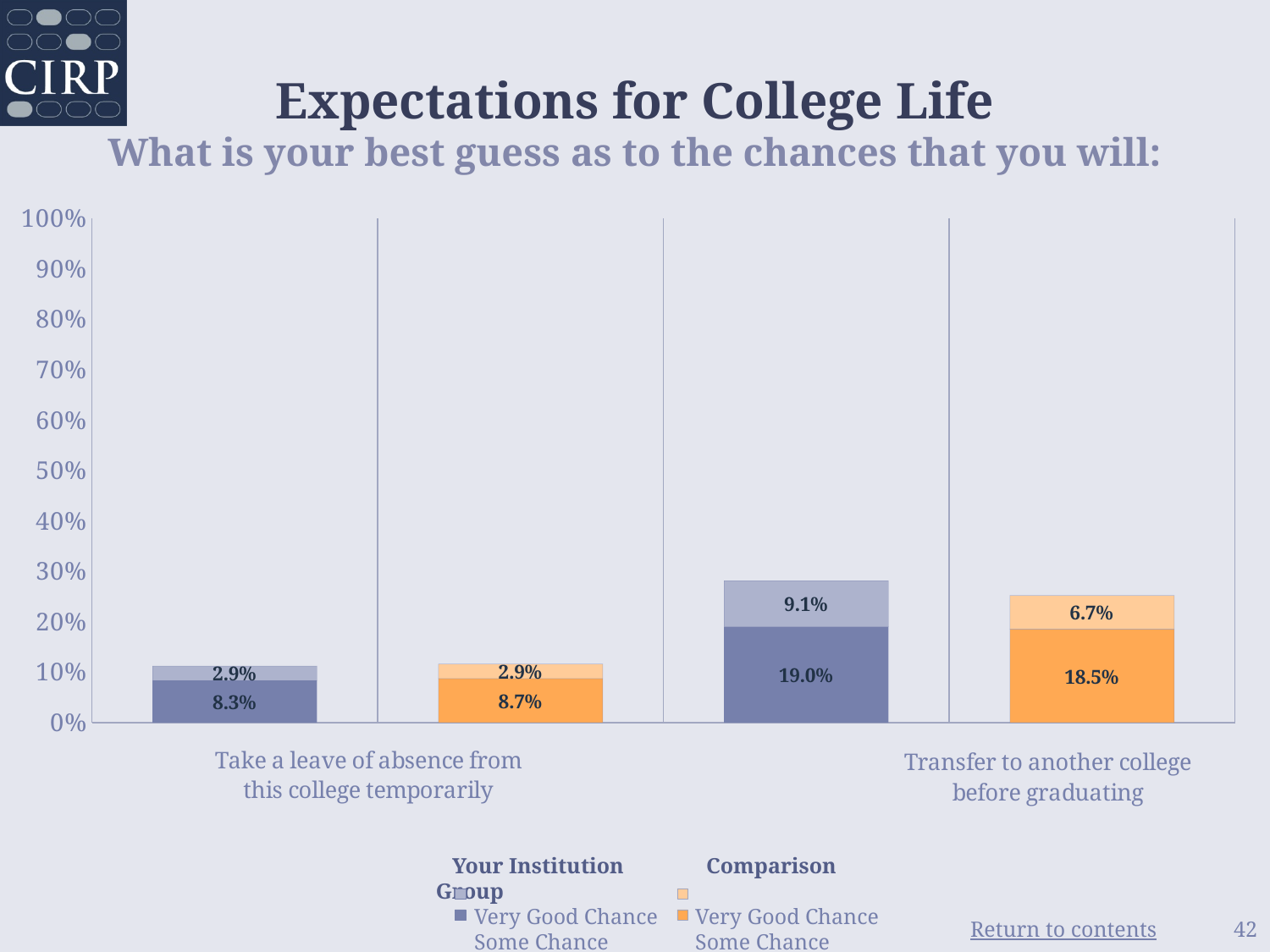
What is the total height of the Comparison Group bar for 'Transfer to another college before graduating'? 25.2% Is the total Your Institution bar for 'Transfer to another college before graduating' greater or less than 20%? greater What is the difference between the Very Good Chance values for Your Institution and the Comparison Group for 'Transfer to another college before graduating'? 2.4% Which has the larger Some Chance value for 'Transfer to another college before graduating', Your Institution or the Comparison Group? Your Institution What type of chart is shown on the slide? Stacked bar chart What is the main title of the chart slide? Expectations for College Life How many categories are shown on the x axis? 2 What is the Very Good Chance value for the Comparison Group for 'Transfer to another college before graduating'? 6.7% What is the Some Chance value for Your Institution for 'Transfer to another college before graduating'? 19.0% What is the Very Good Chance value for Your Institution for 'Take a leave of absence from this college temporarily'? 2.9% What is the Some Chance value for the Comparison Group for 'Take a leave of absence from this college temporarily'? 8.7% What is the total height of the Your Institution bar for 'Transfer to another college before graduating'? 28.1%